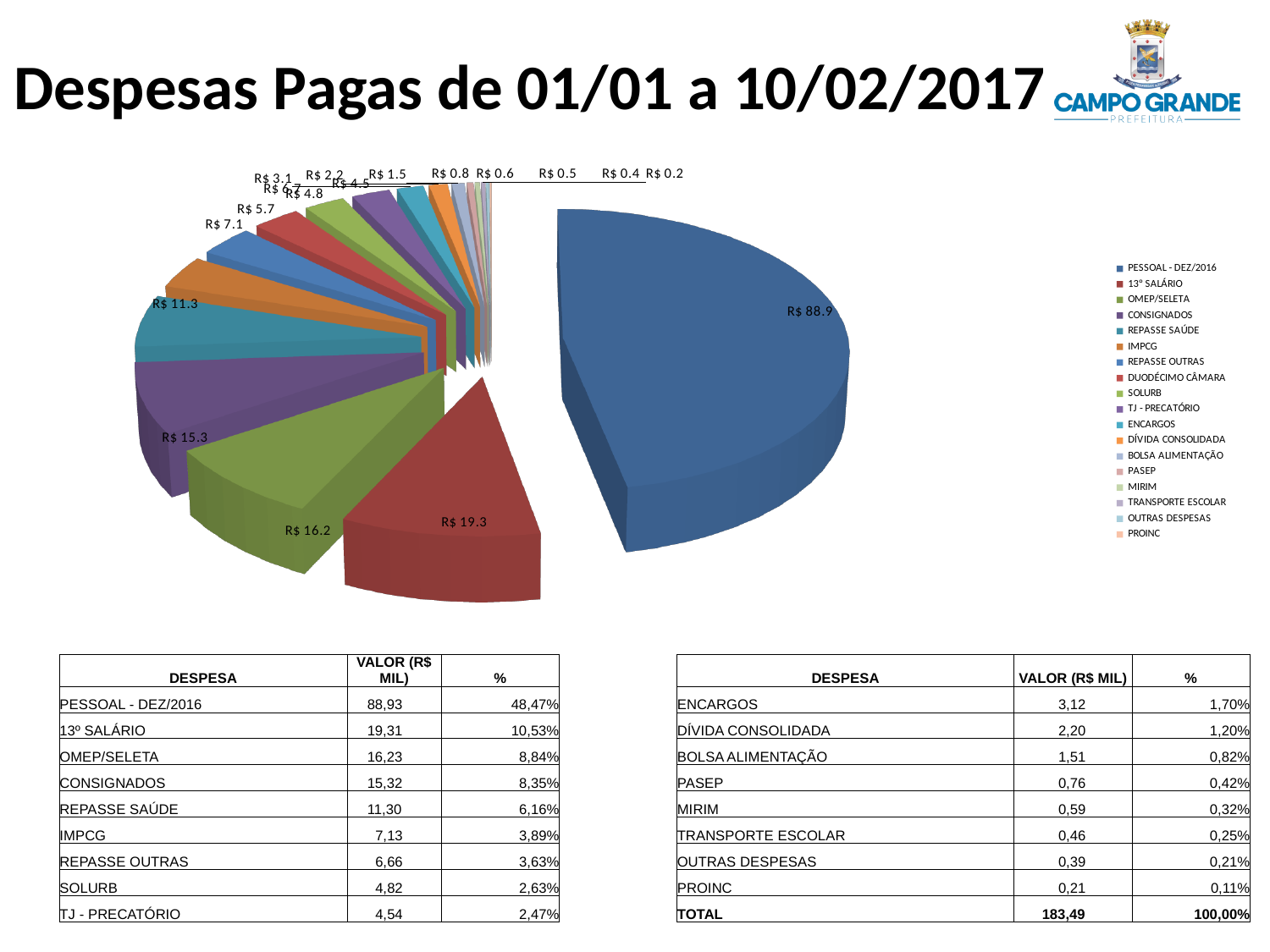
What is the value of the smallest slice in the pie chart? R$ 0.2 What value is labelled on the OMEP/SELETA slice of the pie chart? R$ 16.2 What is the value of the largest slice in the pie chart? R$ 88.9 Which slice is larger in the pie chart: 13º SALÁRIO or OMEP/SELETA? 13º SALÁRIO What value is labelled on the 13º SALÁRIO slice of the pie chart? R$ 19.3 What value is labelled on the REPASSE SAÚDE slice of the pie chart? R$ 11.3 What is the difference between the PESSOAL - DEZ/2016 slice (R$ 88.9) and the 13º SALÁRIO slice (R$ 19.3) in the pie chart? R$ 69.6 What value is labelled on the CONSIGNADOS slice of the pie chart? R$ 15.3 Which category is listed first in the pie chart's legend? PESSOAL - DEZ/2016 What kind of chart is shown on the slide? Pie chart What value is labelled on the PESSOAL - DEZ/2016 slice of the pie chart? R$ 88.9 How many entries does the pie chart's legend list? 18